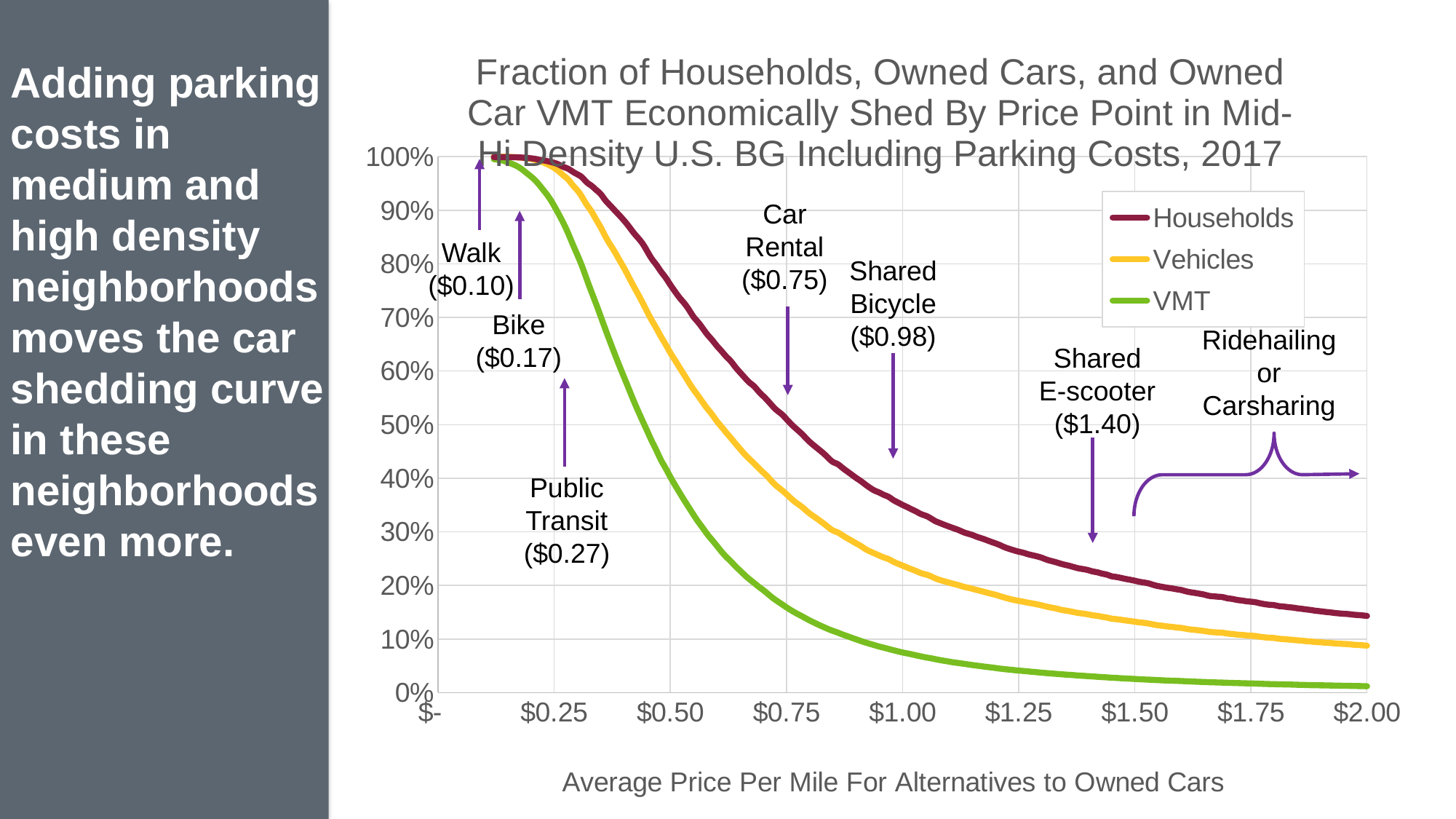
Is the Households value at $2.00 greater or less than 10%? greater Is the VMT value at $2.00 greater or less than 10%? less Which series has the lowest value at $2.00? VMT Which series has the highest value at $1.00? Households Is the Households value at $0.25 greater or less than 90%? greater Which series are listed in the legend? Households, Vehicles, VMT What price per mile is annotated for Shared Bicycle on the chart? $0.98 At $1.00, which is larger: the Households value or the VMT value? Households What kind of chart is shown on the slide? line chart How many series does the legend list? 3 Do the values of the Households line rise or fall as the price per mile increases along the x axis? fall